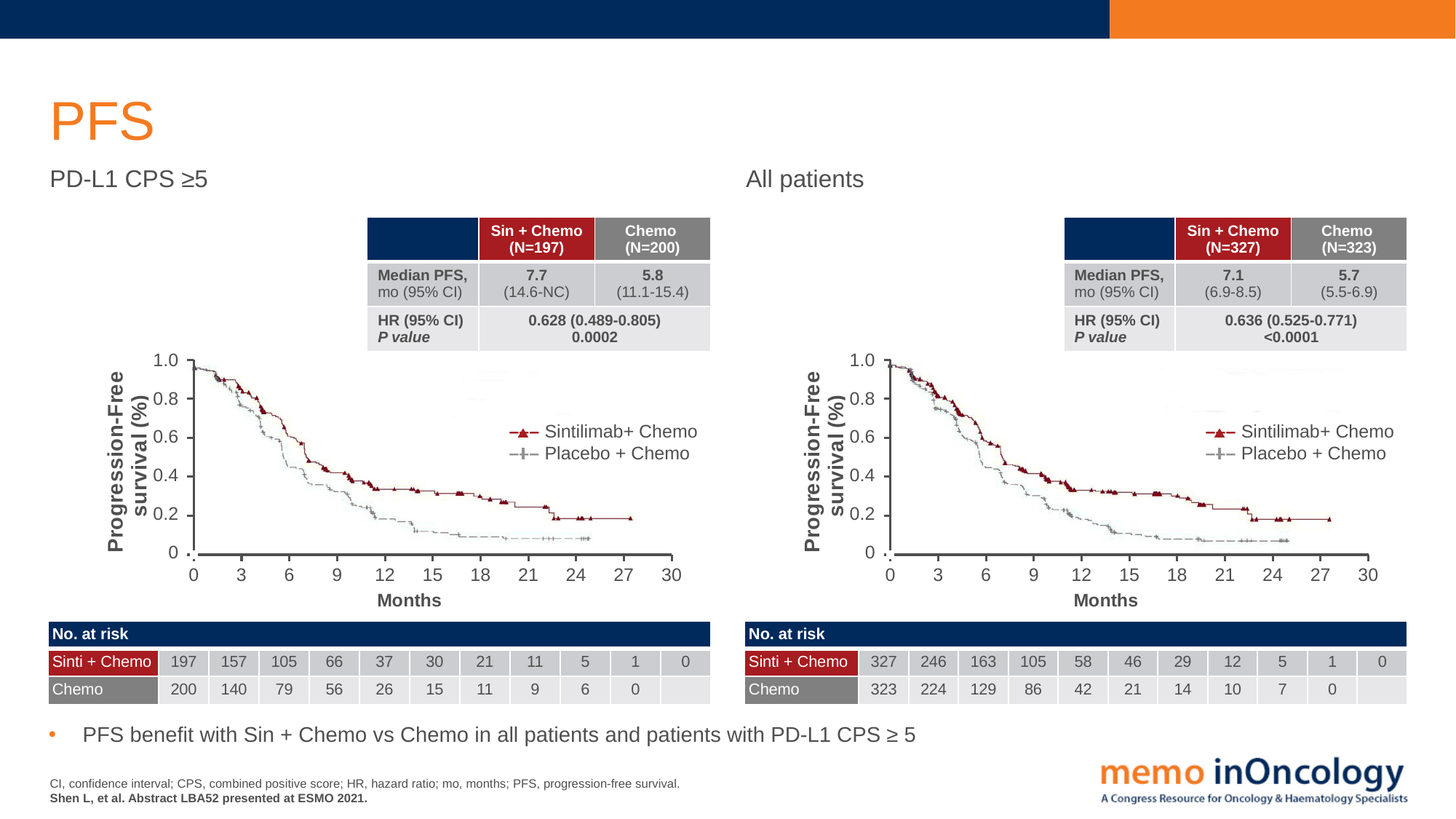
What kind of chart is the PD-L1 CPS ≥5 chart on the left? line chart In the PD-L1 CPS ≥5 chart, is the Sintilimab+ Chemo curve at 3 months greater or less than 0.6? greater In the All patients chart, what is the difference between the number at risk for Sinti + Chemo and Chemo at 0 months? 4 In the All patients chart, do the survival curves rise or fall along the Months axis? fall In the All patients chart, what is the number at risk for Chemo at 12 months? 42 How many series does the legend of the All patients chart list? 2 In the All patients chart, what is the median PFS in months for Sin + Chemo? 7.1 How many time points are listed in the No. at risk table under the PD-L1 CPS ≥5 chart? 11 In the PD-L1 CPS ≥5 chart, which arm has more patients at risk at 12 months, Sinti + Chemo or Chemo? Sinti + Chemo In the All patients chart, is the Placebo + Chemo curve at 12 months greater or less than 0.4? less What are the two legend entries in the PD-L1 CPS ≥5 chart? Sintilimab+ Chemo and Placebo + Chemo In the PD-L1 CPS ≥5 chart, what is the number at risk for Sinti + Chemo at 0 months? 197